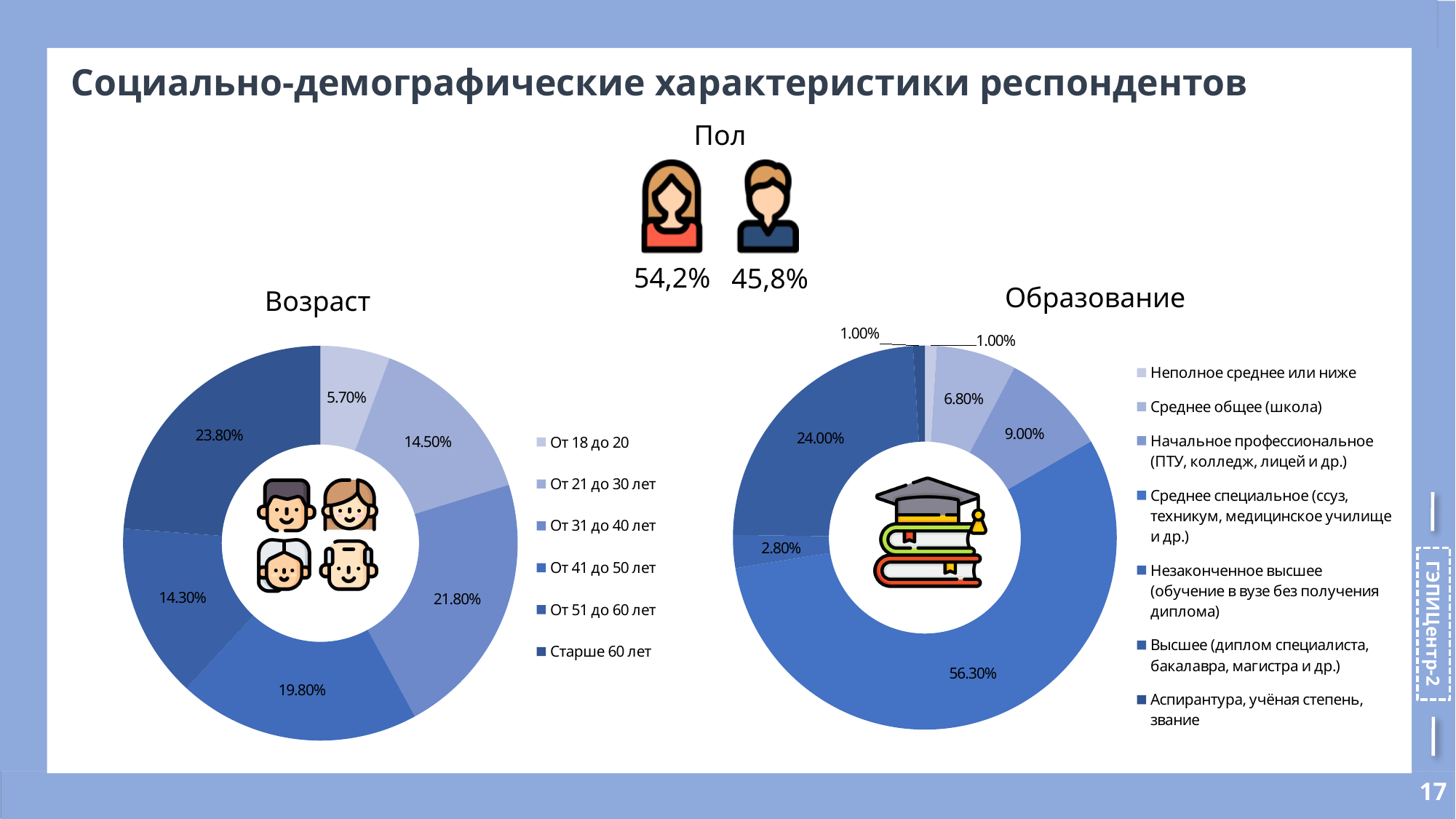
What type of chart is the "Образование" chart? Doughnut chart How many categories does the "Возраст" chart's legend list? 6 In the "Возраст" chart, which is larger: "От 41 до 50 лет" or "От 21 до 30 лет"? От 41 до 50 лет In the "Образование" chart, what is the value for "Незаконченное высшее (обучение в вузе без получения диплома)"? 2.80% In the "Образование" chart, what is the difference between "Высшее (диплом специалиста, бакалавра, магистра и др.)" and "Начальное профессиональное (ПТУ, колледж, лицей и др.)"? 15.00% In the "Возраст" chart, what is the value for "От 18 до 20"? 5.70% In the "Образование" chart, what is the value for "Среднее специальное (ссуз, техникум, медицинское училище и др.)"? 56.30% In the "Образование" chart, which category has the largest share? Среднее специальное (ссуз, техникум, медицинское училище и др.) In the "Возраст" chart, which category has the smallest share? От 18 до 20 In the "Возраст" chart, what is the value for "От 31 до 40 лет"? 21.80% In the "Возраст" chart, which category has the largest share? Старше 60 лет In the "Возраст" chart, what is the difference between "Старше 60 лет" and "От 51 до 60 лет"? 9.50%